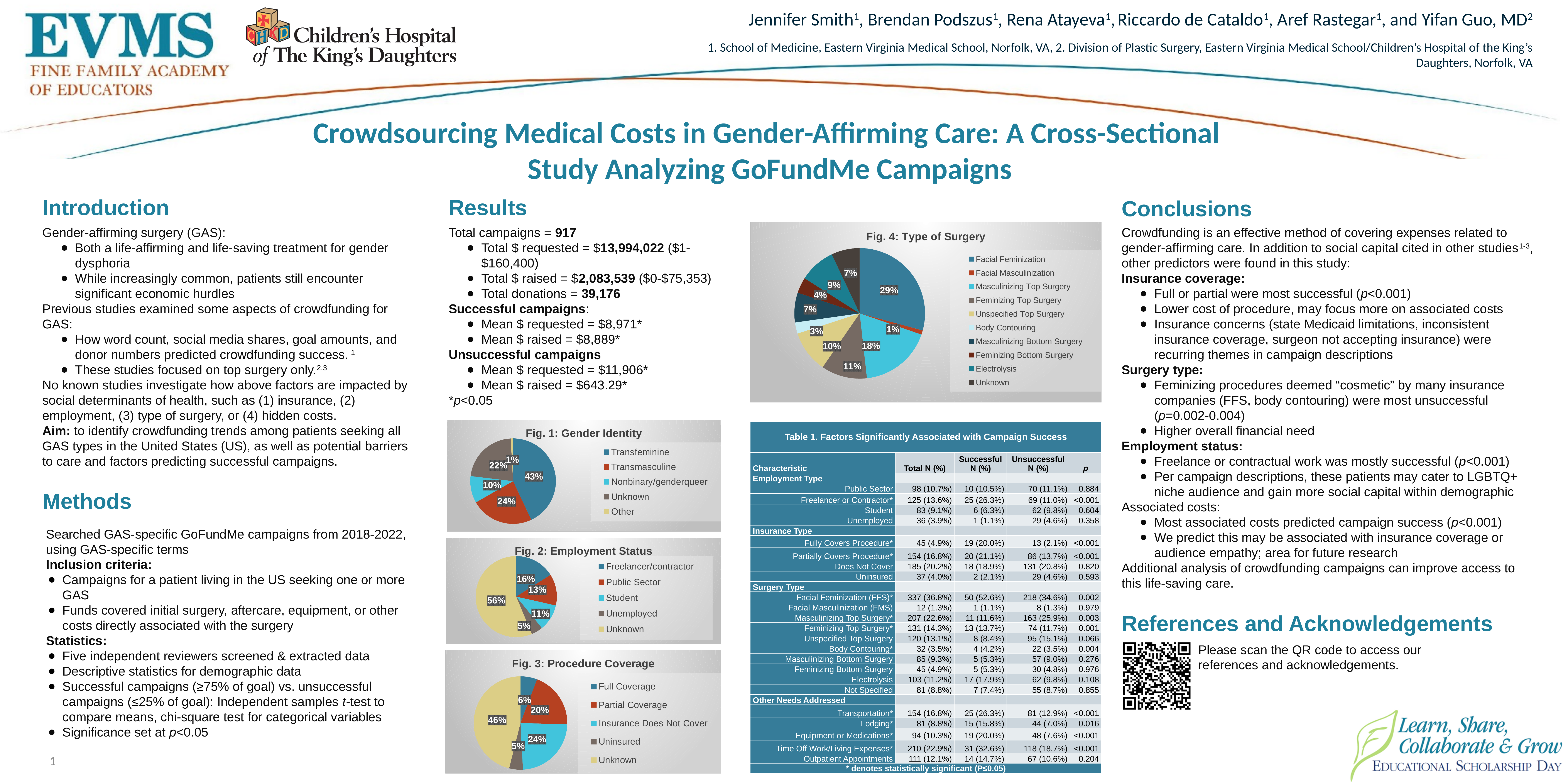
In Fig. 4: Type of Surgery, which category has the largest slice? Facial Feminization In Fig. 1: Gender Identity, which category has the smallest slice? Other In Fig. 4: Type of Surgery, what share of the pie is Masculinizing Top Surgery? 18% In Fig. 3: Procedure Coverage, which category has the largest slice? Unknown In Fig. 1: Gender Identity, how many categories does the legend list? 5 What kind of chart is Fig. 3: Procedure Coverage? Pie chart In Fig. 3: Procedure Coverage, what share of the pie is Partial Coverage? 20% In Fig. 2: Employment Status, what share of the pie is Unknown? 56% In Fig. 4: Type of Surgery, how many categories does the legend list? 10 In Fig. 2: Employment Status, what is the difference between the Student and Unemployed shares? 6% In Fig. 2: Employment Status, which is larger, Freelancer/contractor or Public Sector? Freelancer/contractor